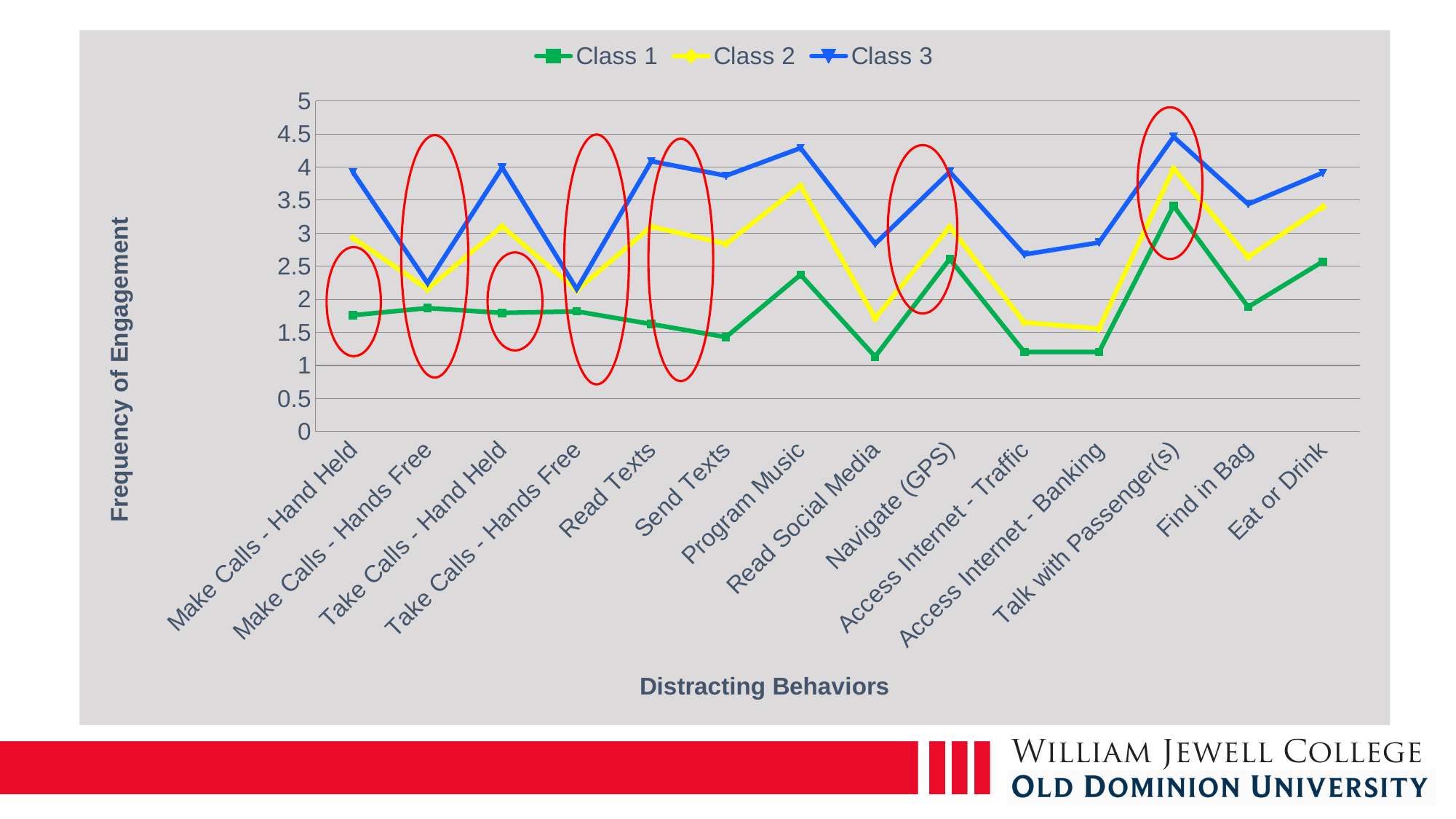
Which series is highest at Read Texts, Class 1 or Class 3? Class 3 How many series does the legend list? 3 Is the Class 3 value for Program Music greater or less than 4? greater How many distracting behaviors are plotted along the x axis? 14 What is the title of the y axis? Frequency of Engagement For which distracting behavior does Class 3 reach its highest value? Talk with Passenger(s) For which distracting behavior does Class 1 reach its highest value? Talk with Passenger(s) Is the Class 3 value for Access Internet - Traffic greater or less than 3? less Is the Class 1 value for Read Social Media greater or less than 1.5? less What type of chart is shown on the slide? line chart Does the Class 1 line rise or fall from Read Social Media to Navigate (GPS)? rise